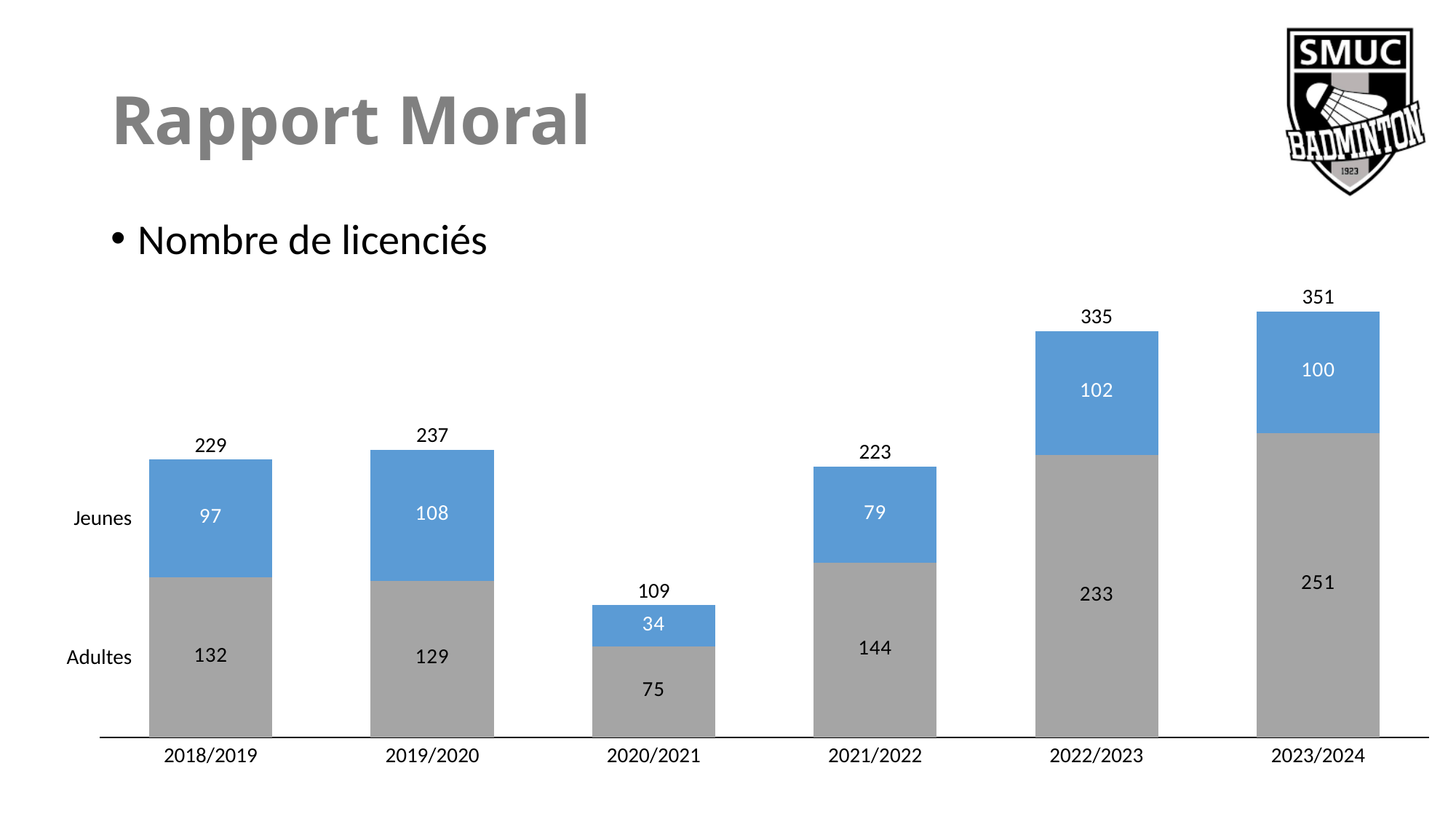
How many series are plotted in the chart? 2 What is the number of Adultes for 2018/2019? 132 Which colour represents the Jeunes series? Blue What is the difference between the Adultes values for 2022/2023 and 2021/2022? 89 What kind of chart is shown on the slide? Stacked bar chart Do the Adultes values rise or fall from 2020/2021 to 2023/2024? Rise Which season has the highest total number of licenciés? 2023/2024 How many seasons are shown on the x axis? 6 Which season has the lowest total number of licenciés? 2020/2021 Which is larger, the Jeunes value for 2019/2020 or for 2022/2023? 2019/2020 What is the number of Jeunes for 2021/2022? 79 What is the total number of licenciés for 2023/2024? 351